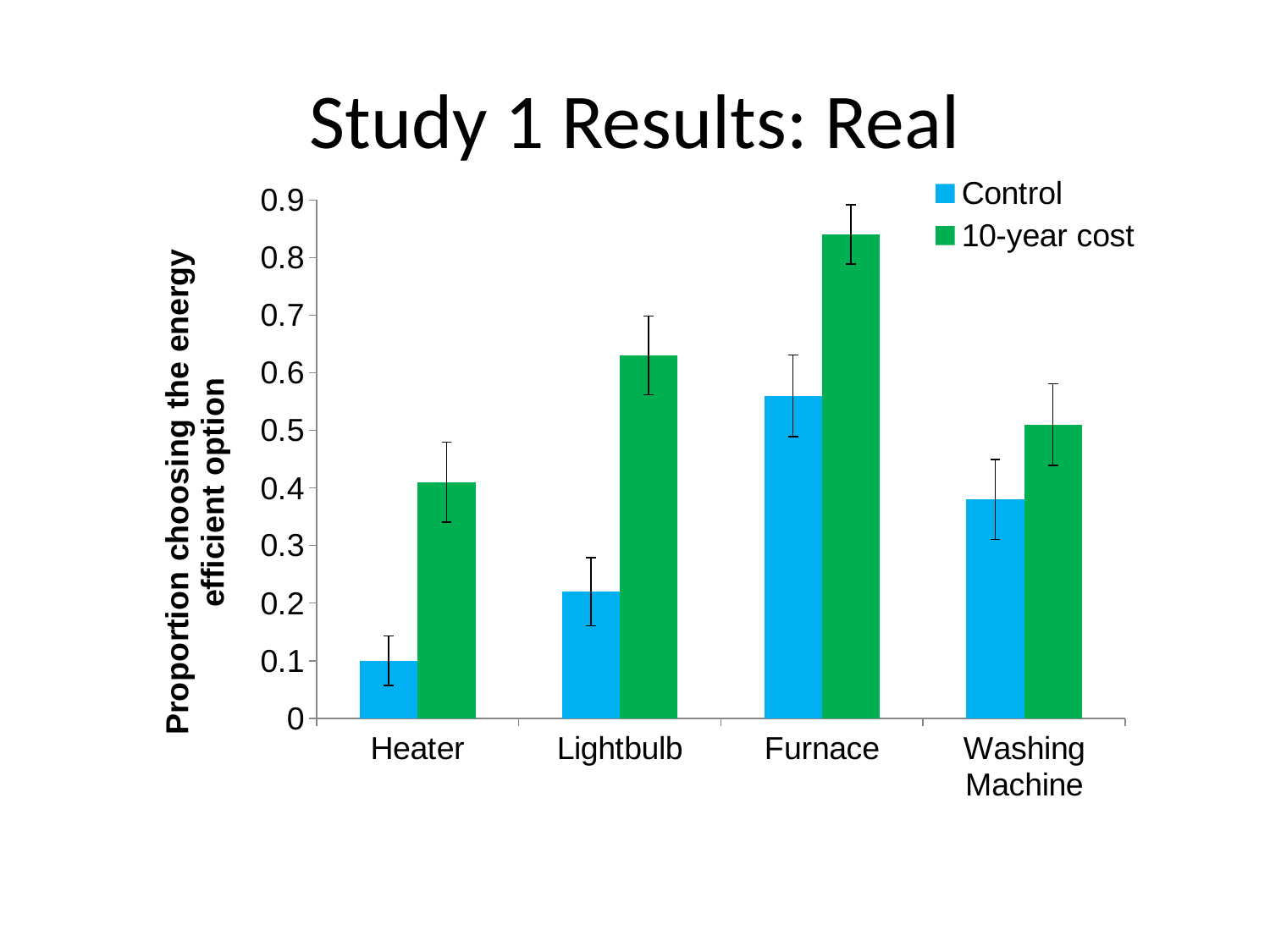
Is the 10-year cost value for Furnace greater or less than 0.8? greater How many categories are shown on the x axis? 4 Is the Control value for Lightbulb greater or less than 0.3? less Which category has the highest 10-year cost value? Furnace What kind of chart is shown on the slide? bar chart Which category has the lowest Control value? Heater Is the 10-year cost value for Heater greater or less than 0.5? less What is the label on the vertical axis? Proportion choosing the energy efficient option Which is larger, the Control value for Furnace or the Control value for Heater? Furnace Which category has the lowest 10-year cost value? Heater How many series does the legend list? 2 Which is larger for Washing Machine, the Control value or the 10-year cost value? 10-year cost